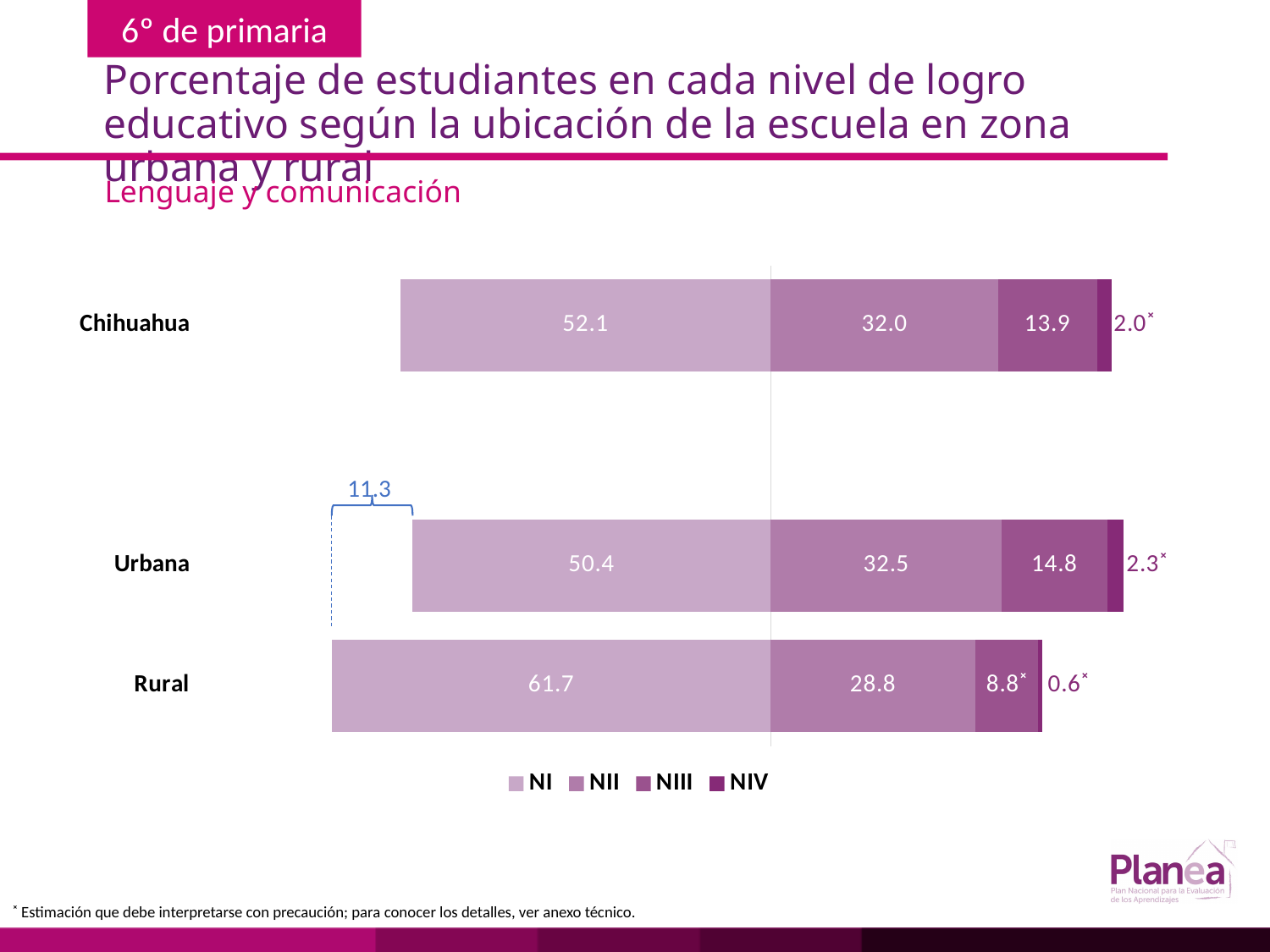
What is the NIV value for Rural? 0.6 What is the NII value for Urbana? 32.5 What is the difference between the NI values for Rural and Urbana? 11.3 What is the total of the stacked bar for Urbana? 100.0 How many series does the legend list? 4 Which category has the lowest NIII value? Rural What is the NI value for Rural? 61.7 Which category has the highest NI value? Rural Which is larger, the NII value for Chihuahua or the NII value for Rural? Chihuahua What is the NIII value for Chihuahua? 13.9 What kind of chart is shown on the slide? Stacked bar chart How many categories (bars) are shown in the chart? 3